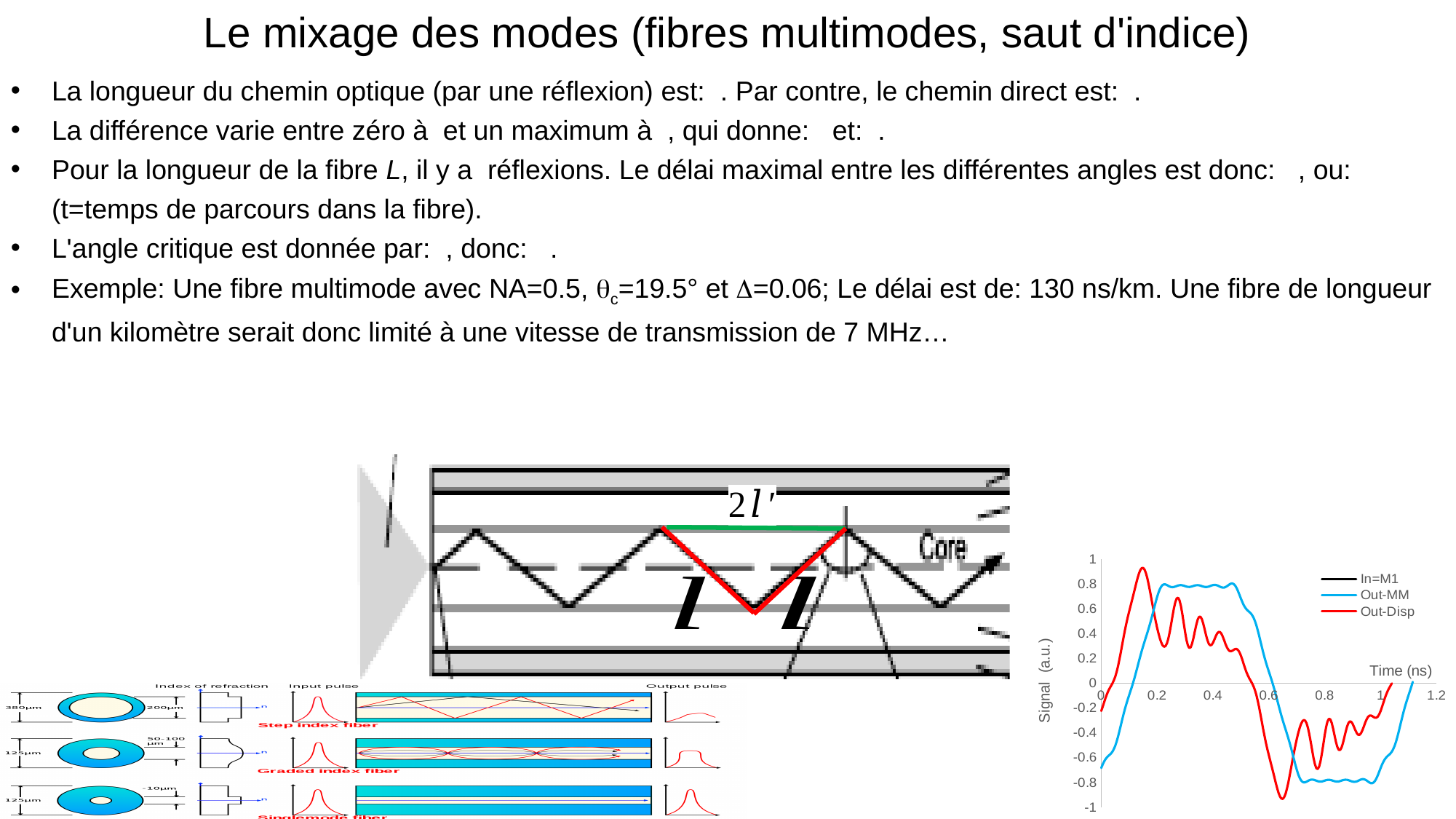
What is the label of the vertical axis of the bottom-right chart? Signal (a.u.) How many series does the legend of the bottom-right chart list? 3 What are the legend entries of the bottom-right chart? In=M1, Out-MM, Out-Disp In the bottom-right chart, is the value of Out-MM at 0.3 ns greater or less than 0.6? greater What kind of chart is shown at the bottom right of the slide? line chart In the bottom-right chart, does the Out-MM series rise or fall between 0.5 ns and 0.7 ns? fall In the bottom-right chart, is the value of Out-MM at 0.4 ns greater or less than 0.4? greater In the bottom-right chart, which series reaches the higher peak value, Out-MM or Out-Disp? Out-Disp In the bottom-right chart, is the value of Out-MM at 0.9 ns greater or less than -0.4? less In the bottom-right chart, does the Out-Disp series rise or fall between 0 ns and 0.15 ns? rise